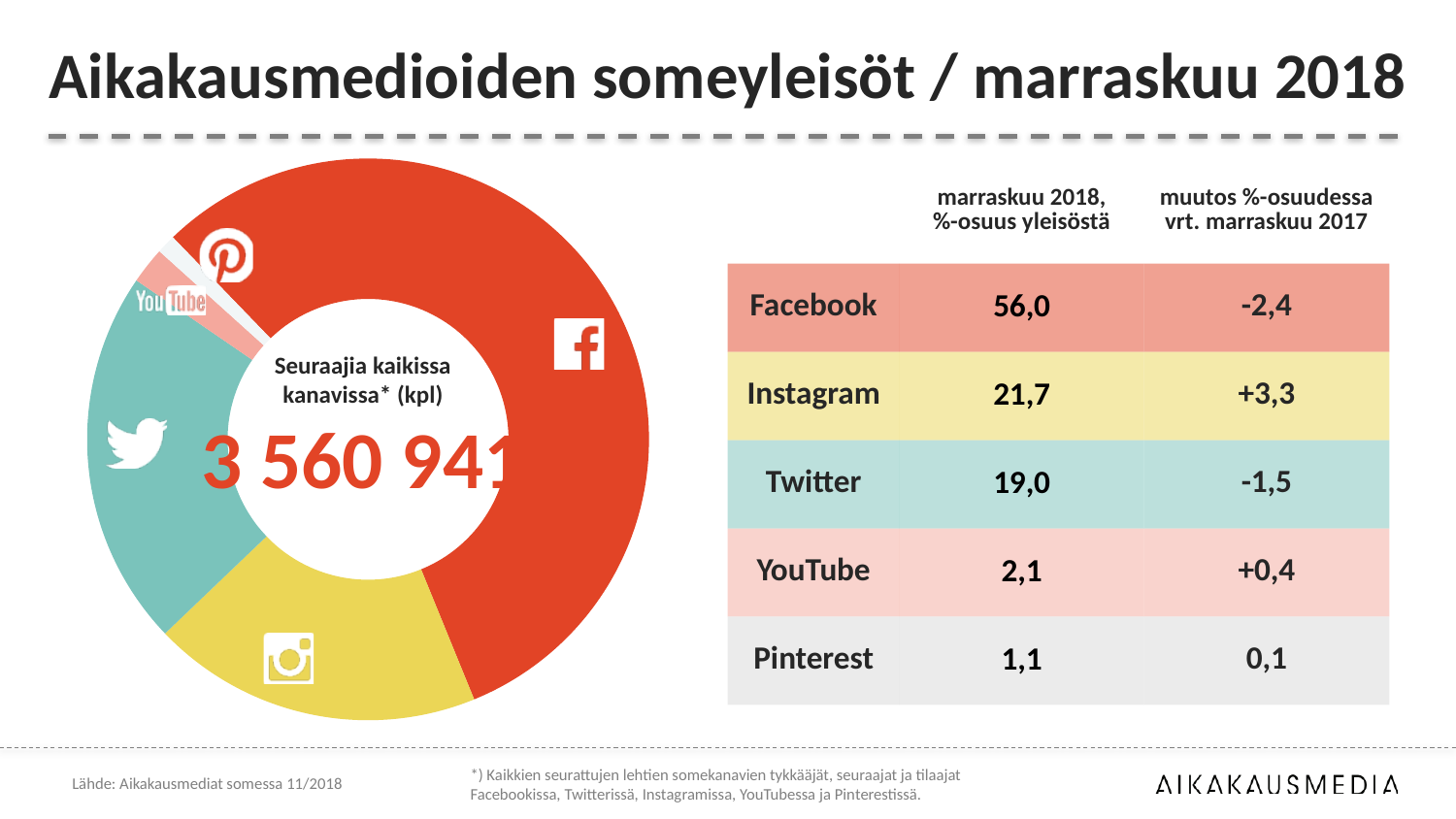
Which has the larger %-share in November 2018, Instagram or Twitter? Instagram What kind of chart is shown on the left of the slide? pie chart (donut) What is the difference between Facebook's and Instagram's %-share in November 2018? 34,3 What is the change in Twitter's %-share compared with November 2017? -1,5 What is Facebook's %-share of the audience in November 2018? 56,0 What is the title of the slide? Aikakausmedioiden someyleisöt / marraskuu 2018 Which channel had the largest positive change in %-share compared with November 2017? Instagram Which channel has the largest share of the audience in the donut chart? Facebook How many social media channels are shown as slices in the donut chart? 5 What is the change in YouTube's %-share compared with November 2017? +0,4 What is Instagram's %-share of the audience in November 2018? 21,7 Which channel has the smallest share of the audience in the donut chart? Pinterest